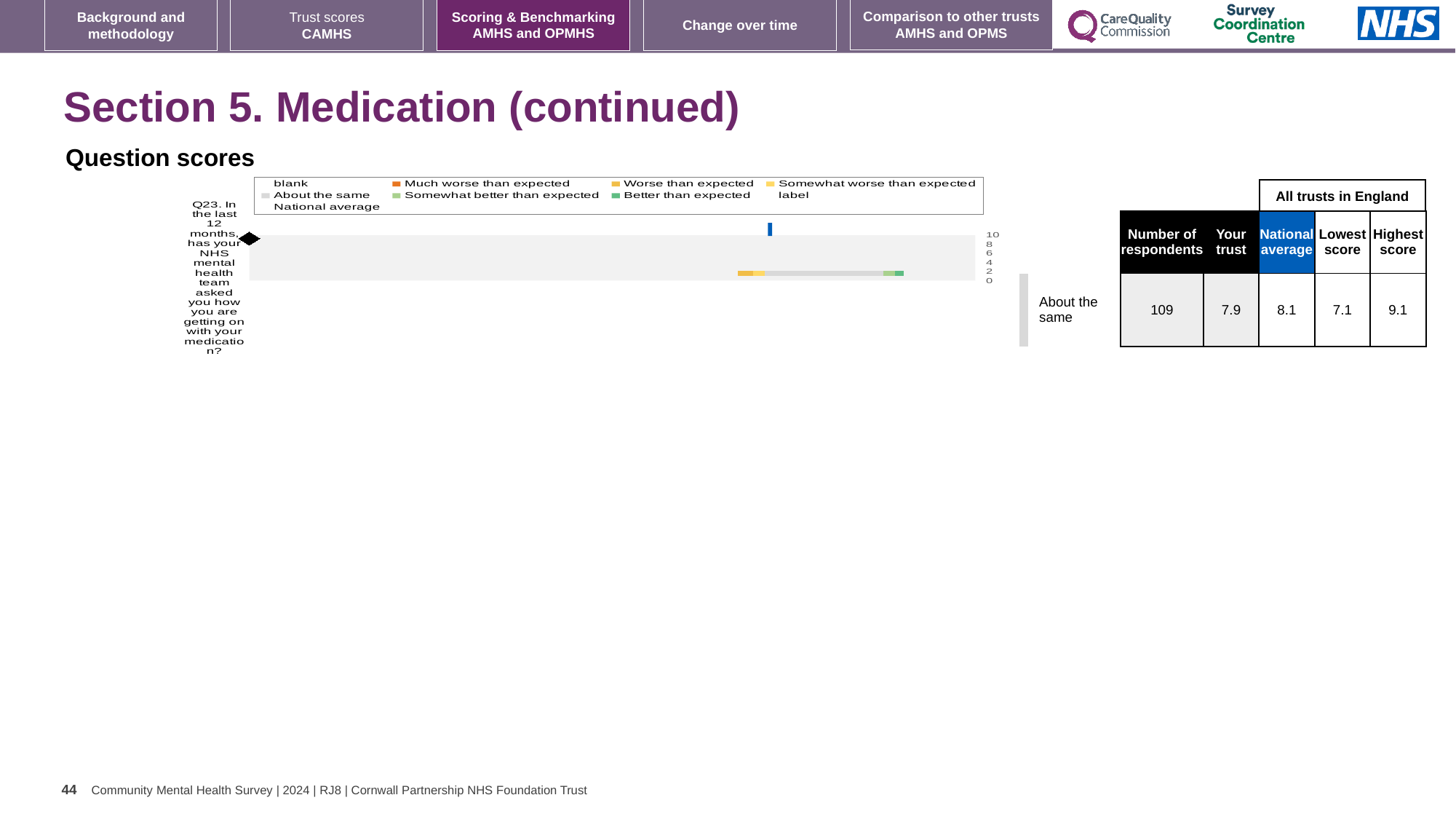
Which is larger for Q23, the trust's score or the national average? national average What is the difference between the highest score and the lowest score for Q23 in the table? 2.0 How many questions (categories) are plotted in the chart? 1 What is the highest tick value shown on the chart's axis? 10 According to the table, what is the national average score for Q23? 8.1 According to the table, what is the highest score among all trusts in England for Q23? 9.1 How many respondents answered Q23 according to the table? 109 Which question number is plotted in the chart? Q23 According to the table, what is the 'Your trust' score for Q23? 7.9 According to the table, what is the lowest score among all trusts in England for Q23? 7.1 How is the trust's Q23 result categorised relative to expectation? About the same What kind of chart is shown on the slide? bar chart